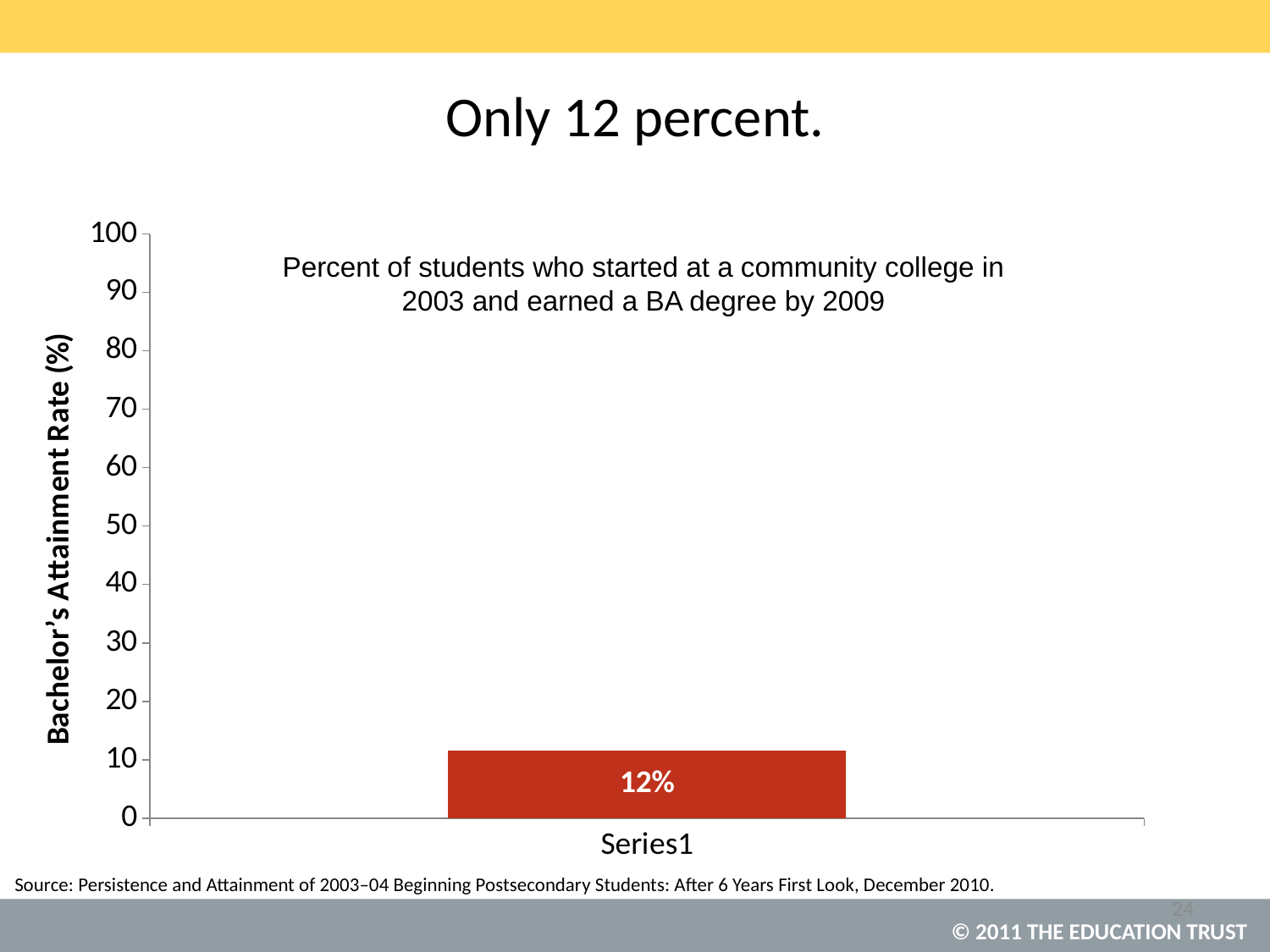
What is the category label shown under the bar on the x axis? Series1 Is the value for Series1 greater or less than 10? greater What is the maximum value shown on the vertical axis of the chart? 100 How many bars are plotted in the chart? 1 Is the value for Series1 greater or less than 20? less What is the label on the vertical axis of the chart? Bachelor's Attainment Rate (%) What kind of chart is shown on the slide? bar chart What is the value shown for Series1 in the bar chart? 12%